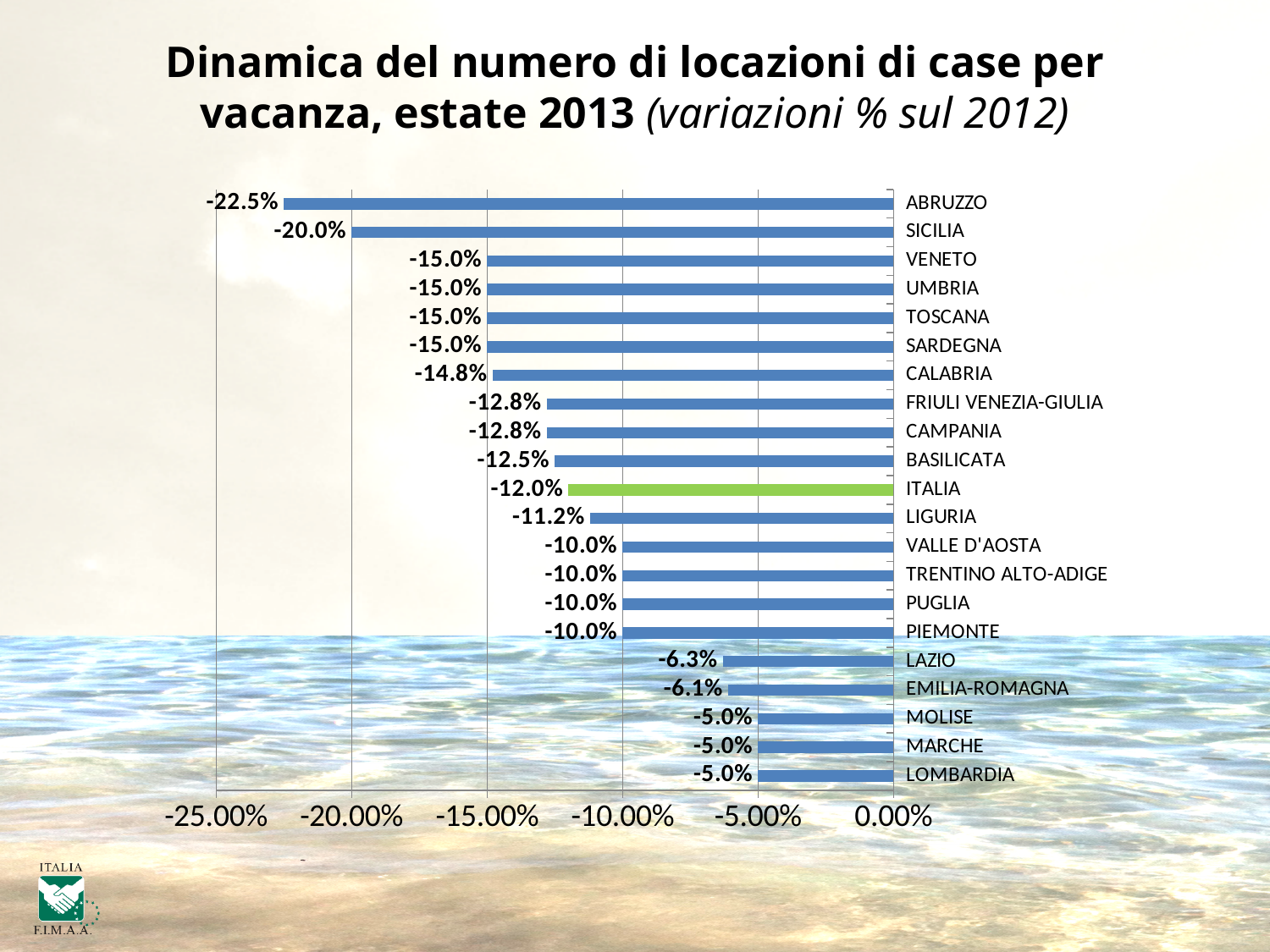
How many categories are plotted in the chart? 21 What is the value for ITALIA? -12.0% What kind of chart is shown on the slide? Bar chart Which region shows the largest percentage decline? ABRUZZO Which has the higher value, LAZIO or PIEMONTE? LAZIO Which category's bar is coloured green instead of blue? ITALIA What is the value for EMILIA-ROMAGNA? -6.1% What is the difference between the values for ITALIA and LIGURIA? 0.8 percentage points What is the difference between the values for ABRUZZO and SICILIA? 2.5 percentage points What is the value for LIGURIA? -11.2% Which shows a larger decline, SICILIA or VENETO? SICILIA What is the value for ABRUZZO? -22.5%